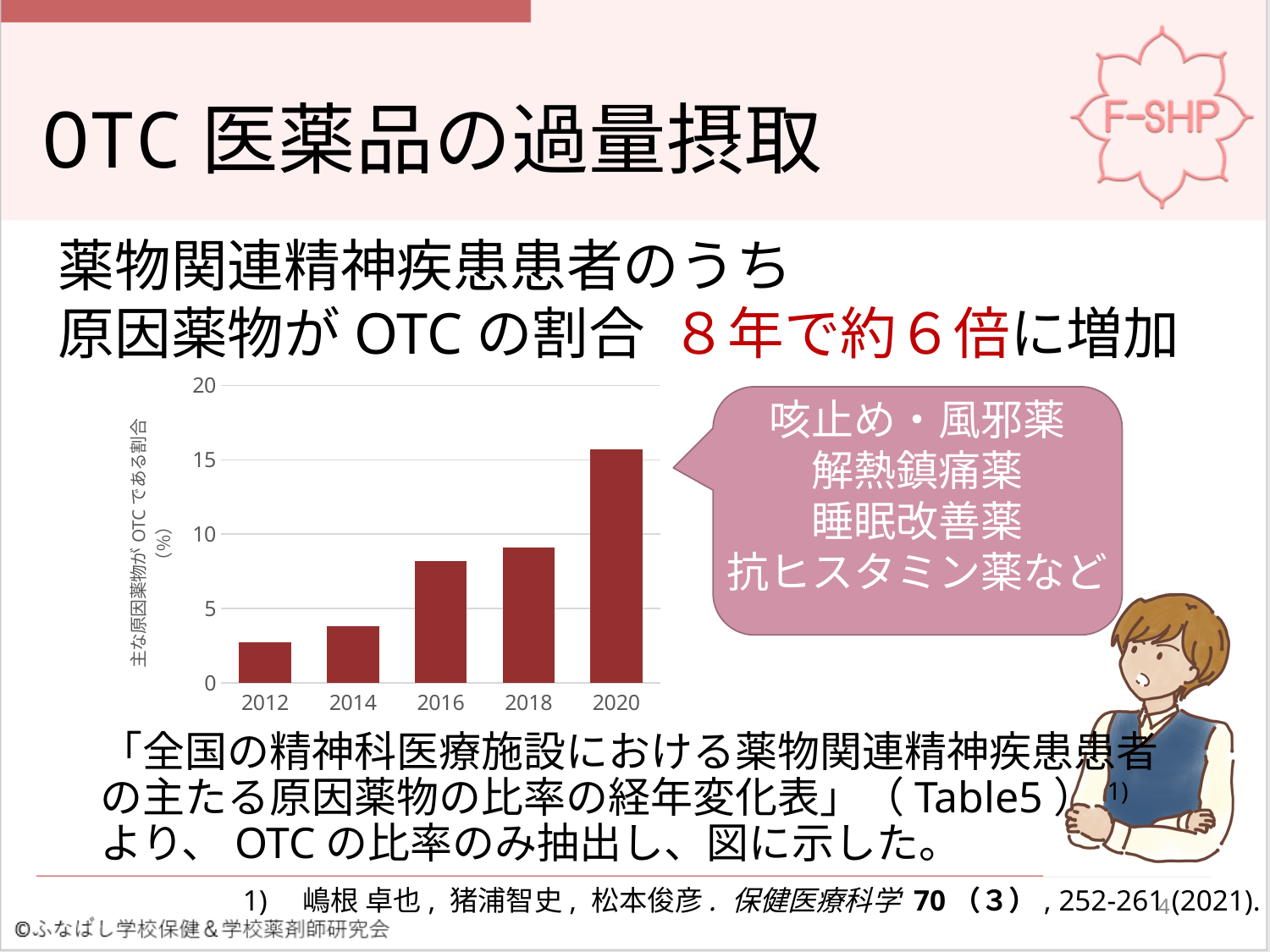
Which year has the lowest bar in the chart? 2012 Is the value for 2012 greater or less than 5? less What is the highest tick value shown on the y axis of the chart? 20 Do the bar values rise or fall from 2012 to 2020? rise What kind of chart is shown on the slide? bar chart How many years are plotted on the x axis of the chart? 5 Is the value for 2018 greater or less than 5? greater Which is larger, the value for 2014 or the value for 2016? 2016 Is the value for 2020 greater or less than 15? greater What is the first year shown on the x axis of the chart? 2012 Which year has the highest bar in the chart? 2020